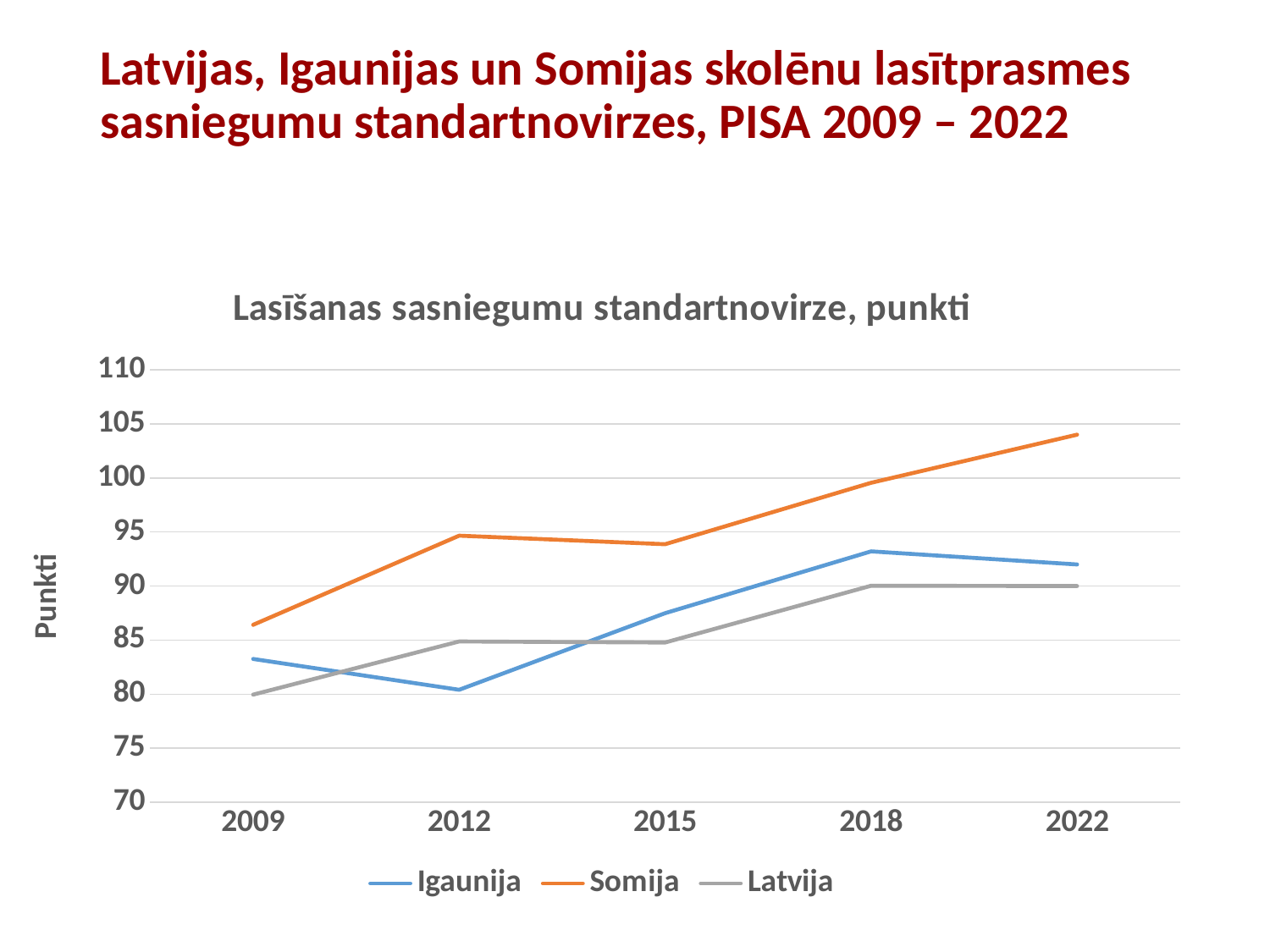
What is the title of the chart? Lasīšanas sasniegumu standartnovirze, punkti What kind of chart is shown on the slide? line chart Which is larger in 2009, the value for Igaunija or the value for Latvija? Igaunija How many years are plotted on the x axis? 5 Is the value for Somija in 2022 greater or less than 100? greater What is the label of the y axis? Punkti How many series does the legend list? 3 Is the value for Igaunija in 2012 greater or less than 85? less Which series is lowest in 2012? Igaunija Which series is highest in 2022? Somija Does the Somija series rise or fall from 2015 to 2022? rise Is the value for Latvija in 2015 greater or less than 90? less